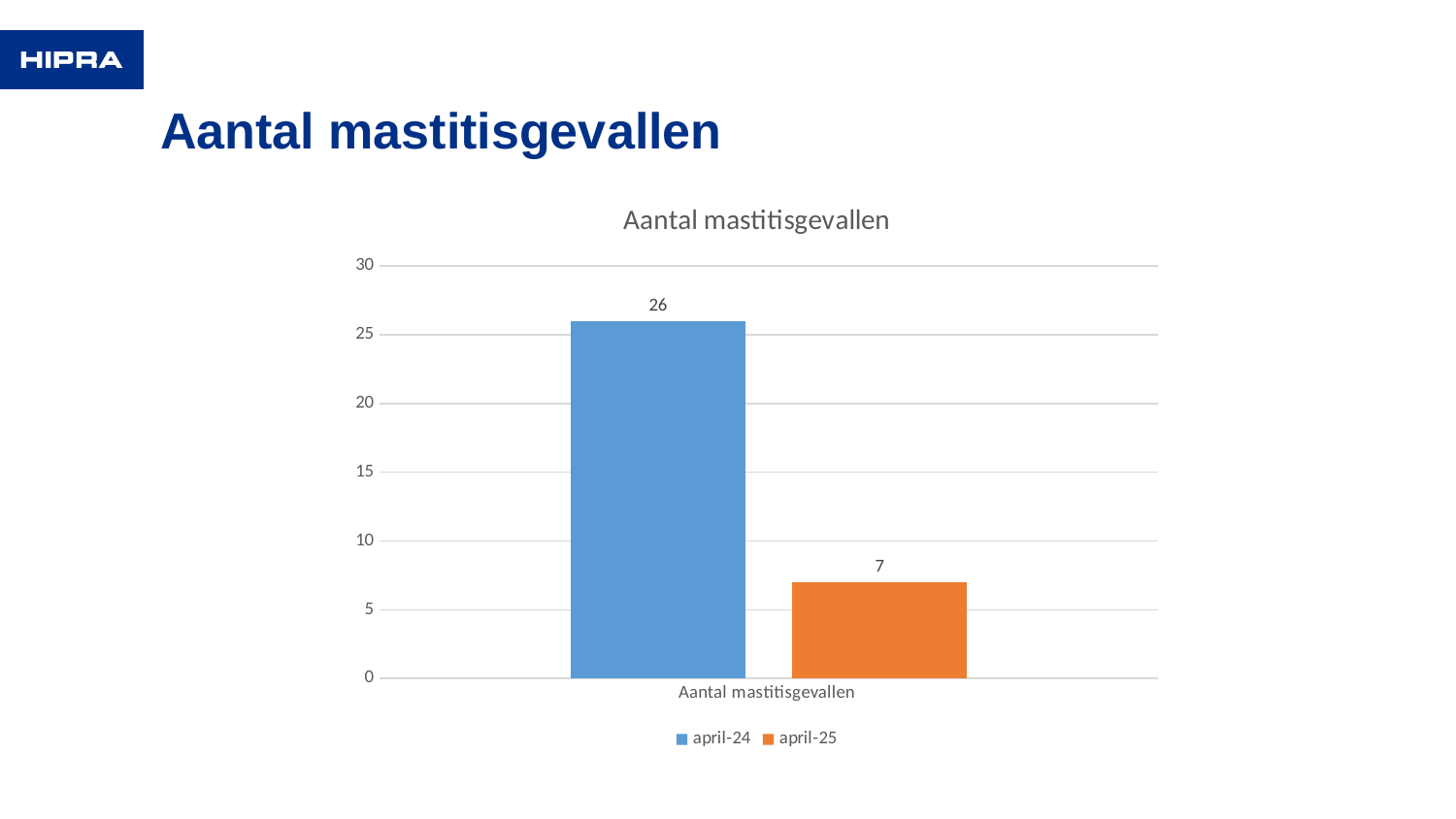
What is the value for april-24 in the chart? 26 What is the title of the chart? Aantal mastitisgevallen Which series has the higher value, april-24 or april-25? april-24 How many series does the legend list? 2 Is the value for april-24 greater or less than 25? greater Is the value for april-24 larger than the value for april-25? Yes What colour is the bar for april-25? Orange What is the value for april-25 in the chart? 7 Which series has the lower value in the chart? april-25 Is the value for april-25 greater or less than 10? less What is the difference between the april-24 and april-25 values? 19 What kind of chart is shown on the slide? Bar chart